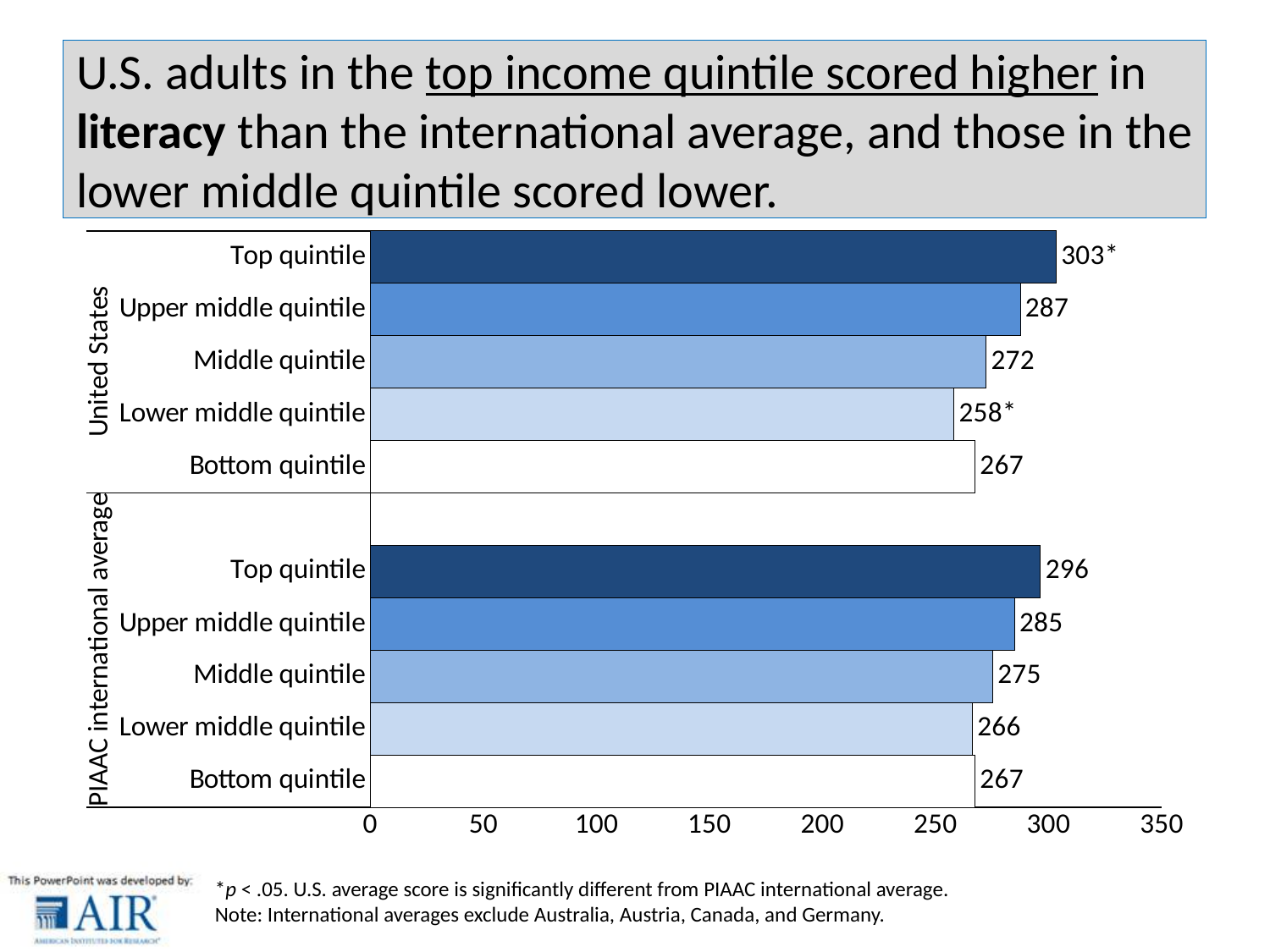
How many bars are plotted in the chart? 10 Which has the larger Top quintile literacy score, the United States or the PIAAC international average? United States What is the difference between the Middle quintile scores for the PIAAC international average and the United States? 3 What is the literacy score for the Lower middle quintile in the PIAAC international average? 266 Which United States quintile has the lowest literacy score? Lower middle quintile What is the literacy score for the Middle quintile in the PIAAC international average? 275 What is the difference between the Upper middle quintile scores for the United States and the PIAAC international average? 2 What is the literacy score for the Upper middle quintile in the United States? 287 What kind of chart is shown on the slide? bar chart Is the value for the United States Bottom quintile greater or less than 250? greater What is the literacy score for the Bottom quintile in the United States? 267 Which United States quintile has the highest literacy score? Top quintile